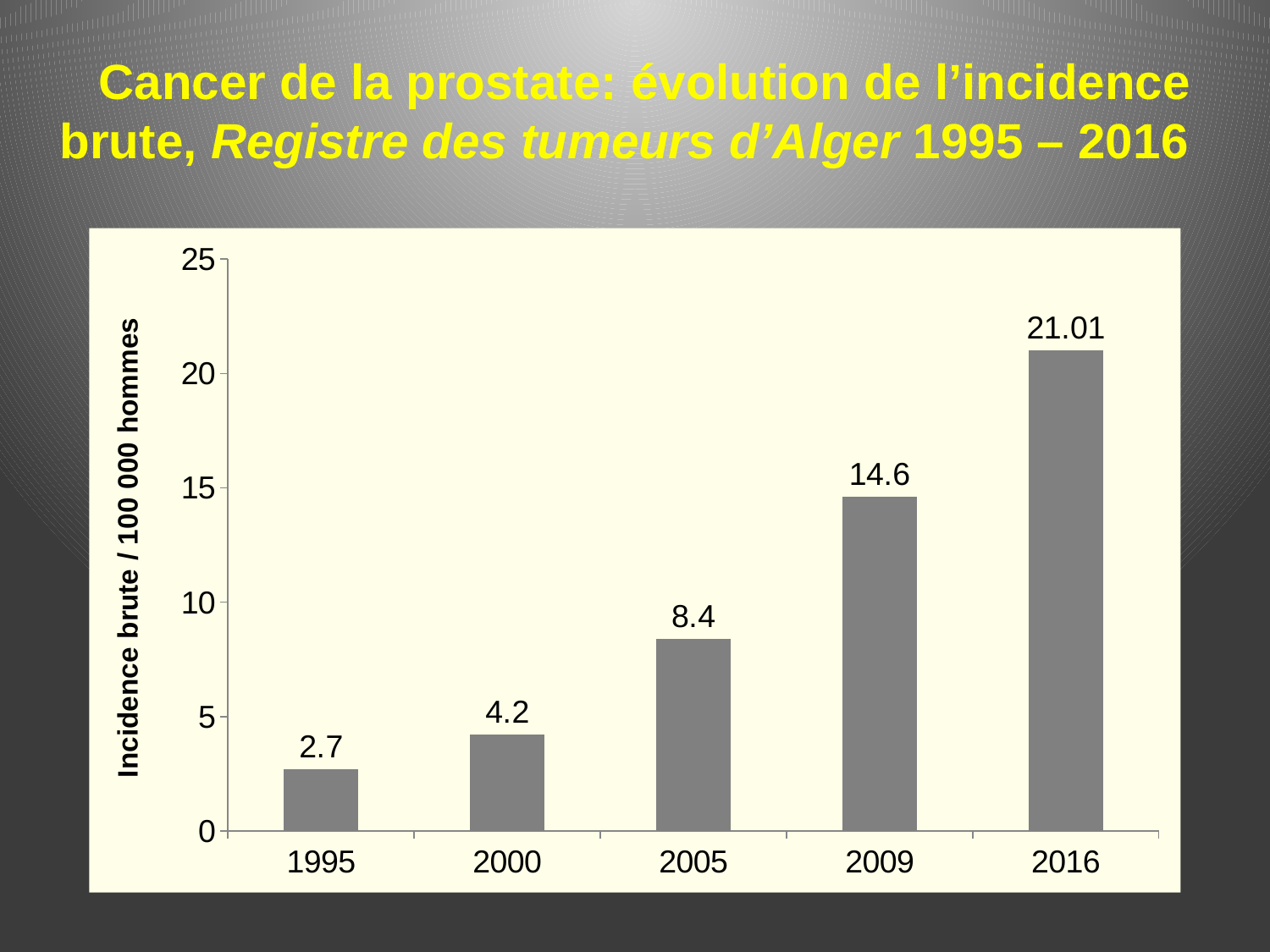
What is the crude incidence value for 1995? 2.7 Which year has the highest crude incidence? 2016 What kind of chart is shown on the slide? Bar chart What is the label of the y axis? Incidence brute / 100 000 hommes Do the values rise or fall from 1995 to 2016? Rise What is the crude incidence value for 2016? 21.01 Which is larger, the value for 2009 or the value for 2005? 2009 How many years are shown on the x axis? 5 What is the crude incidence value for 2009? 14.6 Is the value for 2016 greater or less than 20? greater Which year has the lowest crude incidence? 1995 What is the difference between the values for 2005 and 2000? 4.2